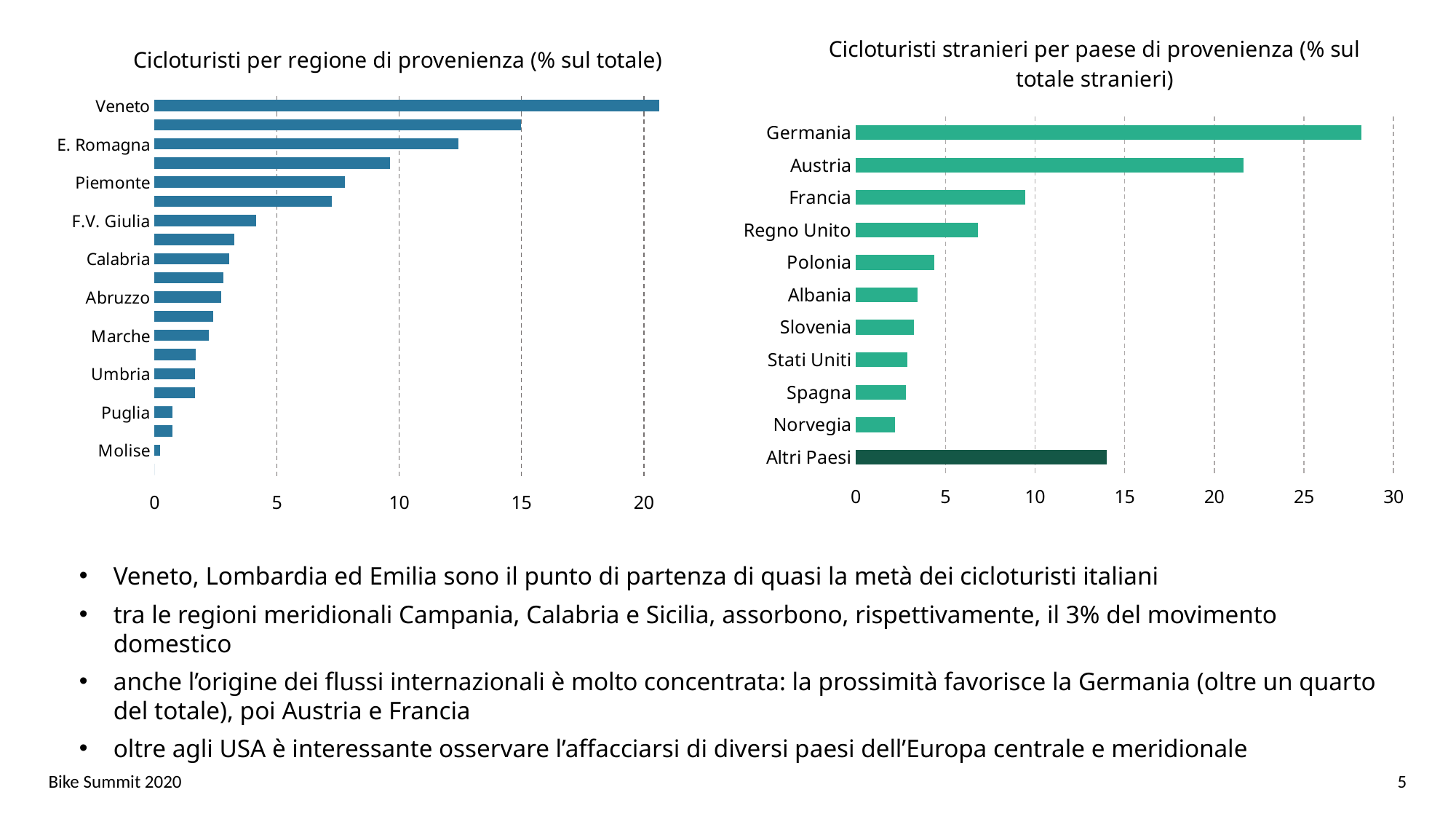
In the chart "Cicloturisti stranieri per paese di provenienza (% sul totale stranieri)", which is larger, the value for Austria or the value for Francia? Austria In the chart "Cicloturisti per regione di provenienza (% sul totale)", which region has the highest value? Veneto In the chart "Cicloturisti per regione di provenienza (% sul totale)", is the value for E. Romagna greater or less than 10? greater How many categories are shown in the chart "Cicloturisti stranieri per paese di provenienza (% sul totale stranieri)"? 11 In the chart "Cicloturisti per regione di provenienza (% sul totale)", is the value for F.V. Giulia greater or less than 5? less In the chart "Cicloturisti stranieri per paese di provenienza (% sul totale stranieri)", which category has the lowest value? Norvegia In the chart "Cicloturisti per regione di provenienza (% sul totale)", which region has the lowest value? Molise In the chart "Cicloturisti per regione di provenienza (% sul totale)", which is larger, the value for Piemonte or the value for Calabria? Piemonte In the chart "Cicloturisti stranieri per paese di provenienza (% sul totale stranieri)", which country has the highest value? Germania In the chart "Cicloturisti stranieri per paese di provenienza (% sul totale stranieri)", is the value for Germania greater or less than 25? greater What kind of chart is the chart titled "Cicloturisti per regione di provenienza (% sul totale)"? bar chart